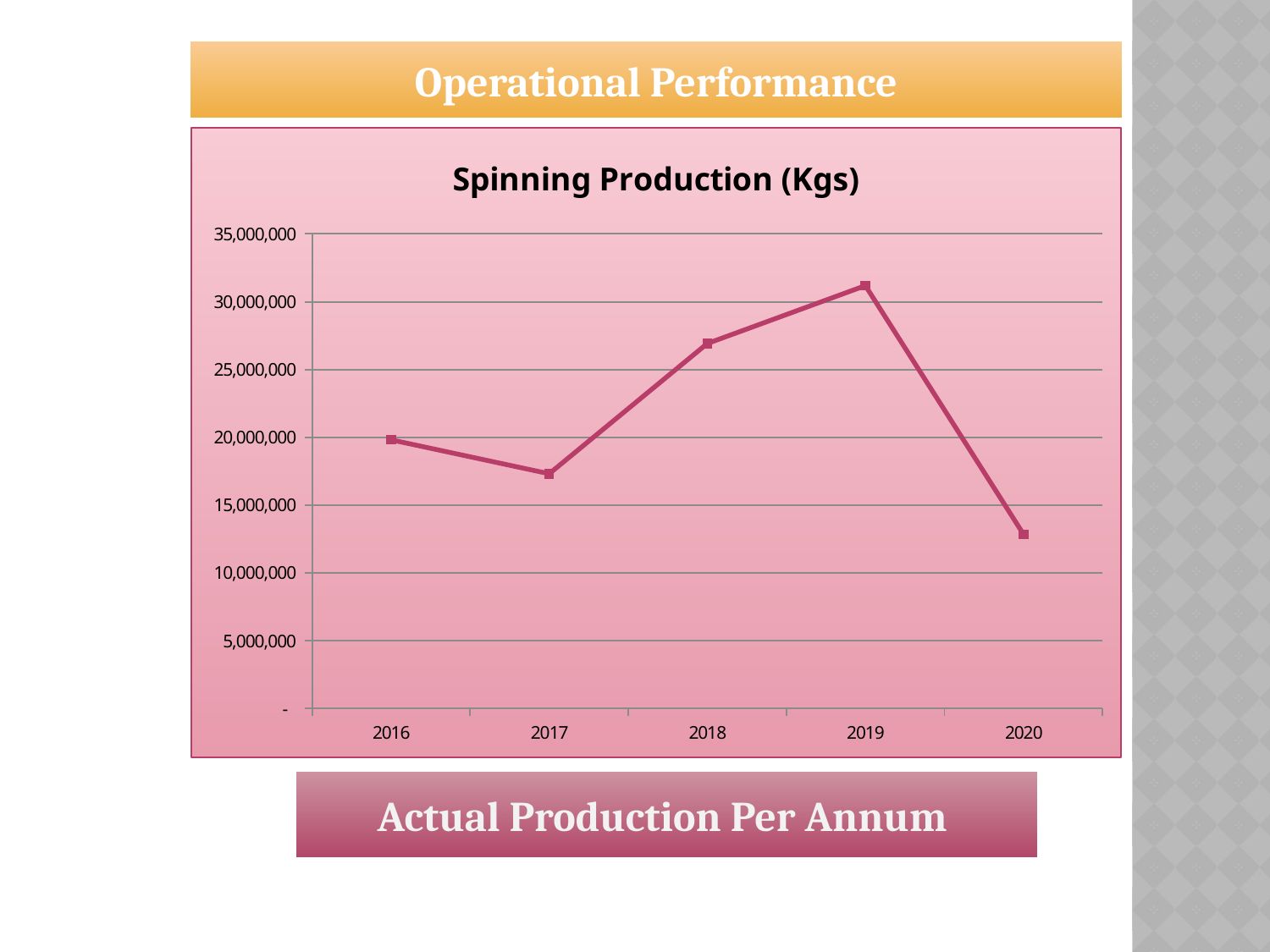
How many years are plotted on the x axis? 5 Is the value for 2018 greater or less than 25,000,000? greater Which year has the larger spinning production, 2016 or 2020? 2016 Which year has the larger spinning production, 2017 or 2018? 2018 Is the value for 2017 greater or less than 20,000,000? less Does spinning production rise or fall from 2019 to 2020? fall Which year has the lowest spinning production? 2020 What is the title of the chart? Spinning Production (Kgs) What kind of chart is shown on the slide? line chart Which year has the highest spinning production? 2019 Is the value for 2020 greater or less than 15,000,000? less